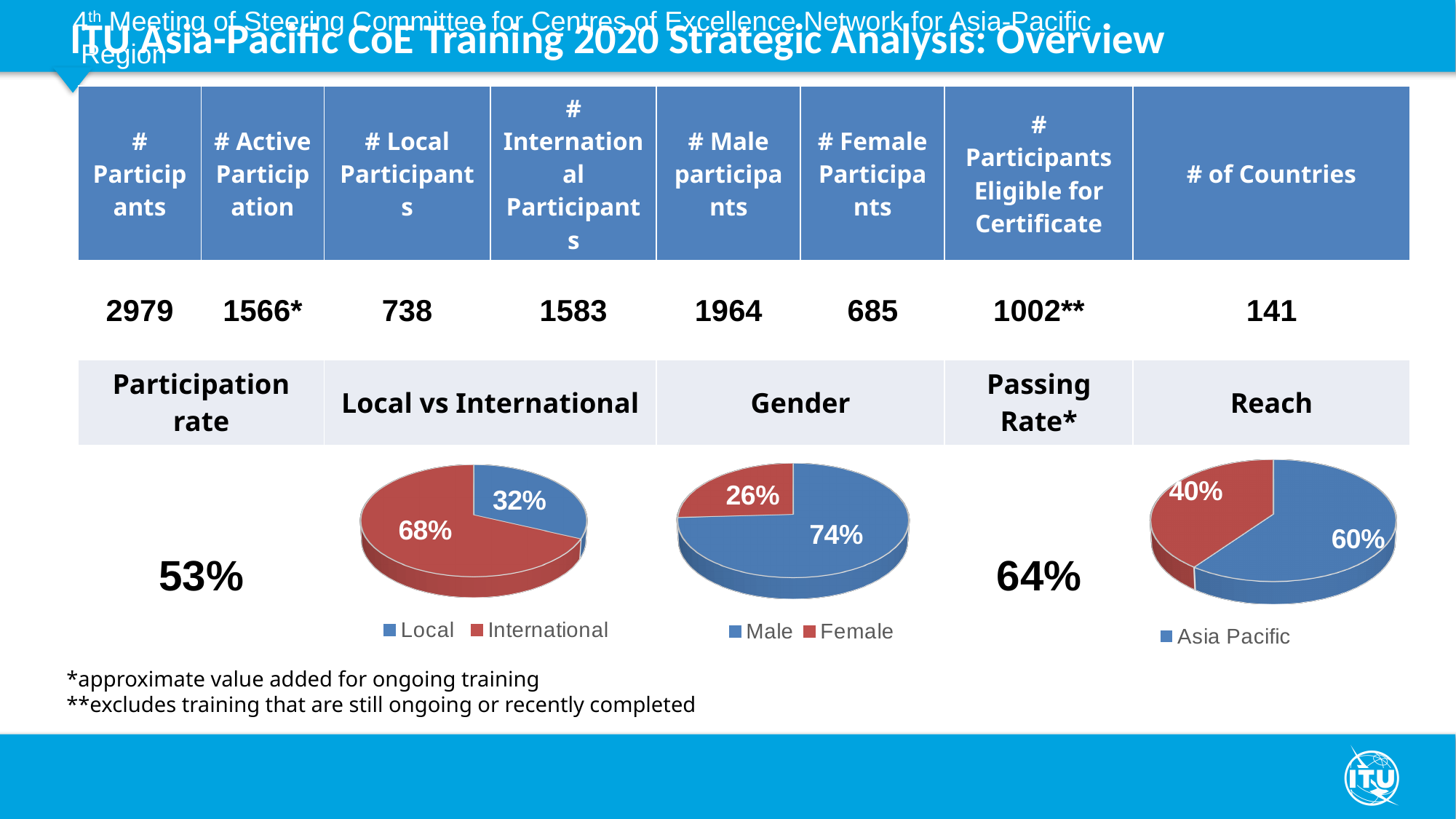
In the Gender pie chart, what share is Female? 26% In the Gender pie chart, what share is Male? 74% In the Local vs International pie chart, which slice is larger, Local or International? International In the Local vs International pie chart, what share is International? 68% How many entries does the legend of the Gender pie chart list? 2 In the Gender pie chart, what is the difference between the Male and Female shares? 48% What kind of chart is used under the Gender heading? Pie chart In the Gender pie chart, which slice is the largest? Male In the Local vs International pie chart, what is the difference between the International and Local shares? 36%